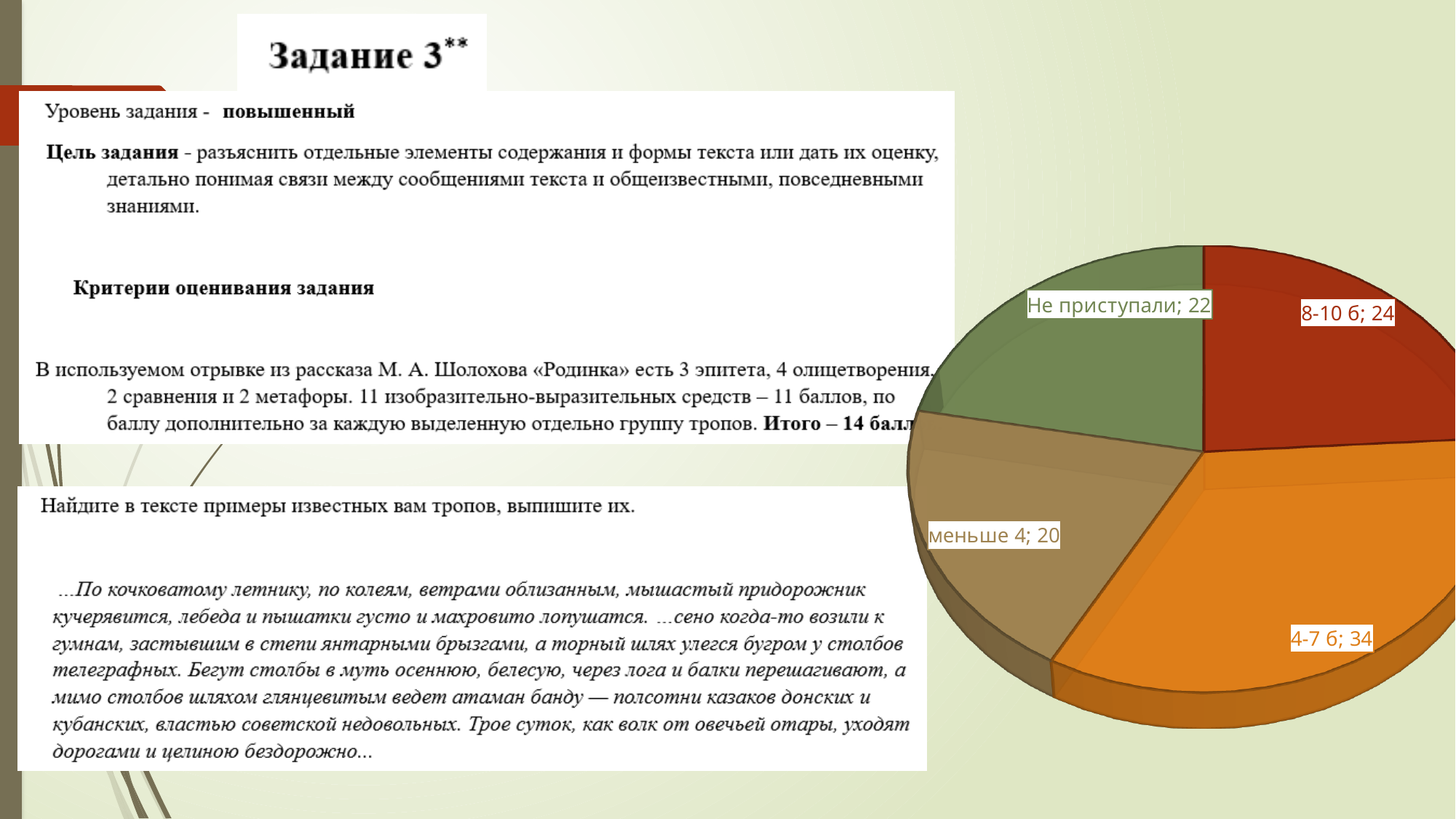
What is the difference between the values for "4-7 б" and "меньше 4"? 14 Which is larger, the value for "8-10 б" or the value for "Не приступали"? 8-10 б What is the value for the slice labelled "меньше 4"? 20 What share of the whole pie does the "4-7 б" slice represent? 34% What is the value for the slice labelled "Не приступали"? 22 What is the value for the slice labelled "4-7 б"? 34 How many slices does the pie chart have? 4 What colour is the "4-7 б" slice of the pie chart? orange Which slice of the pie chart has the smallest value? меньше 4 Which slice of the pie chart has the largest value? 4-7 б What is the value for the slice labelled "8-10 б"? 24 What kind of chart is shown on the slide? pie chart